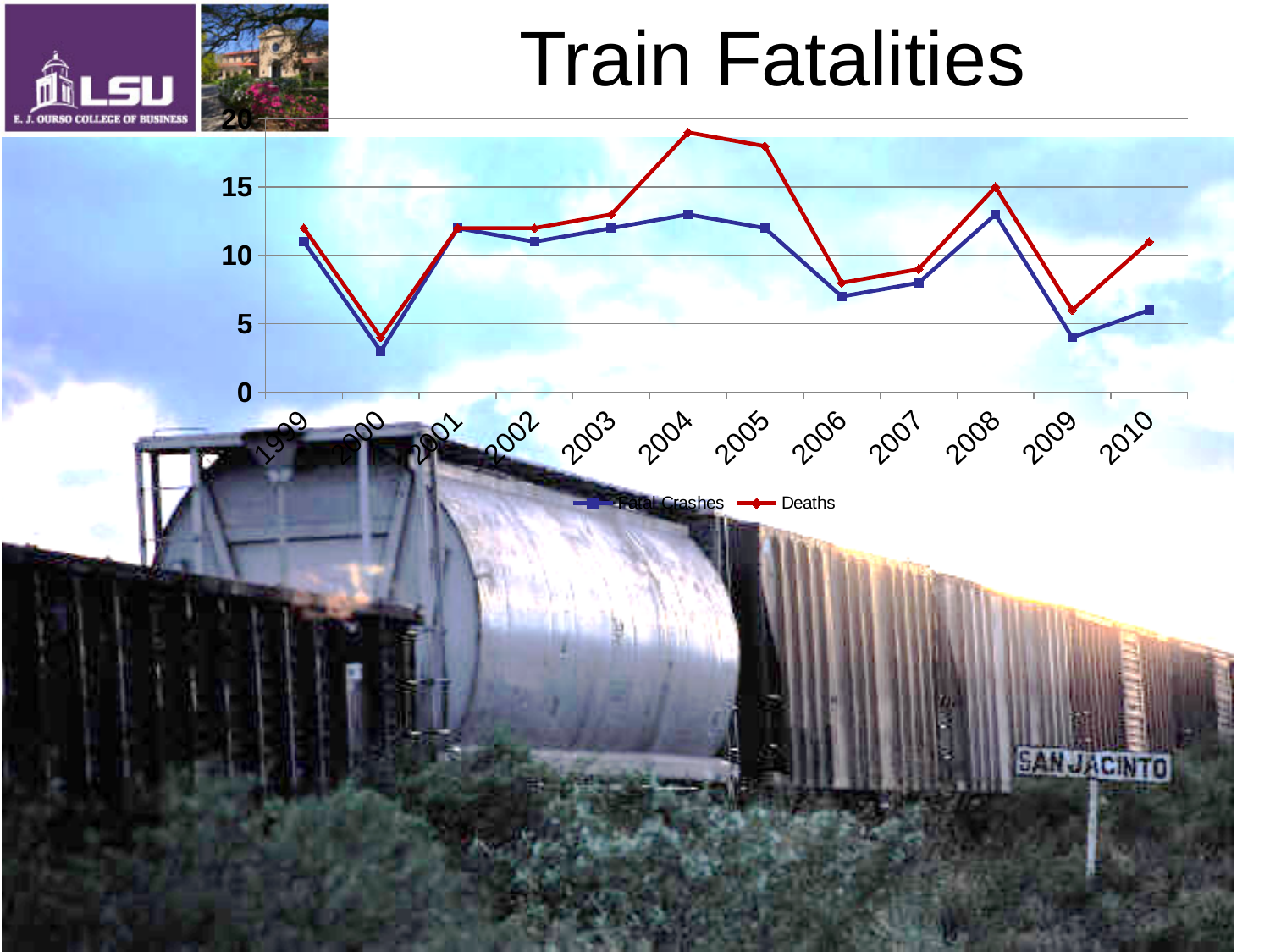
Is the value for Fatal Crashes in 2000 greater or less than 5? less Do both series rise or fall from 2008 to 2009? fall In which year is the Deaths series at its highest? 2004 How many years are plotted along the x axis? 12 Is the value for Deaths in 2004 greater or less than 15? greater Is the value for Deaths in 2006 greater or less than 10? less What colour is the Deaths line? red Which is larger: Deaths in 2004 or Deaths in 2008? Deaths in 2004 What kind of chart is shown on the slide? line chart In which year is the Deaths series at its lowest? 2000 How many series does the legend list? 2